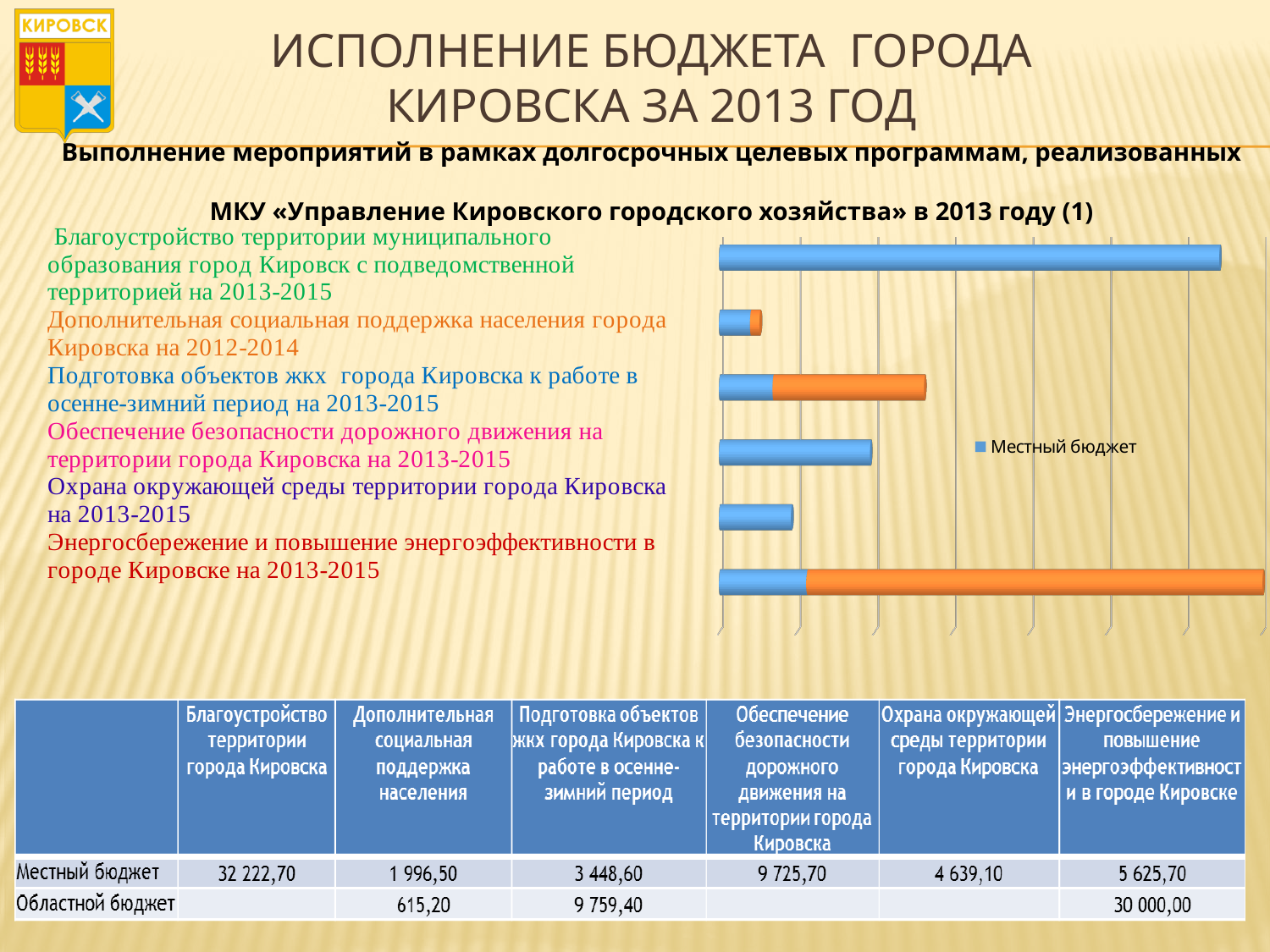
How many series does the chart legend list? 1 What is the total of "Местный бюджет" and "Областной бюджет" for "Подготовка объектов жкх города Кировска к работе в осенне-зимний период"? 13 208,00 What kind of chart is shown on the slide? Bar chart According to the data table, what is the "Местный бюджет" value for "Благоустройство территории города Кировска"? 32 222,70 According to the data table, what is the "Областной бюджет" value for "Энергосбережение и повышение энергоэффективности в городе Кировске"? 30 000,00 What colour represents the series "Местный бюджет" in the chart? Blue Which has the larger "Местный бюджет" value: "Обеспечение безопасности дорожного движения на территории города Кировска" or "Охрана окружающей среды территории города Кировска"? Обеспечение безопасности дорожного движения на территории города Кировска Which program has the smallest "Местный бюджет" value? Дополнительная социальная поддержка населения Which program has the largest "Местный бюджет" value? Благоустройство территории города Кировска What is the name of the series shown in the chart legend? Местный бюджет How many bars does the chart contain? 6 What is the difference between the "Местный бюджет" values for "Благоустройство территории города Кировска" and "Энергосбережение и повышение энергоэффективности в городе Кировске"? 26 597,00